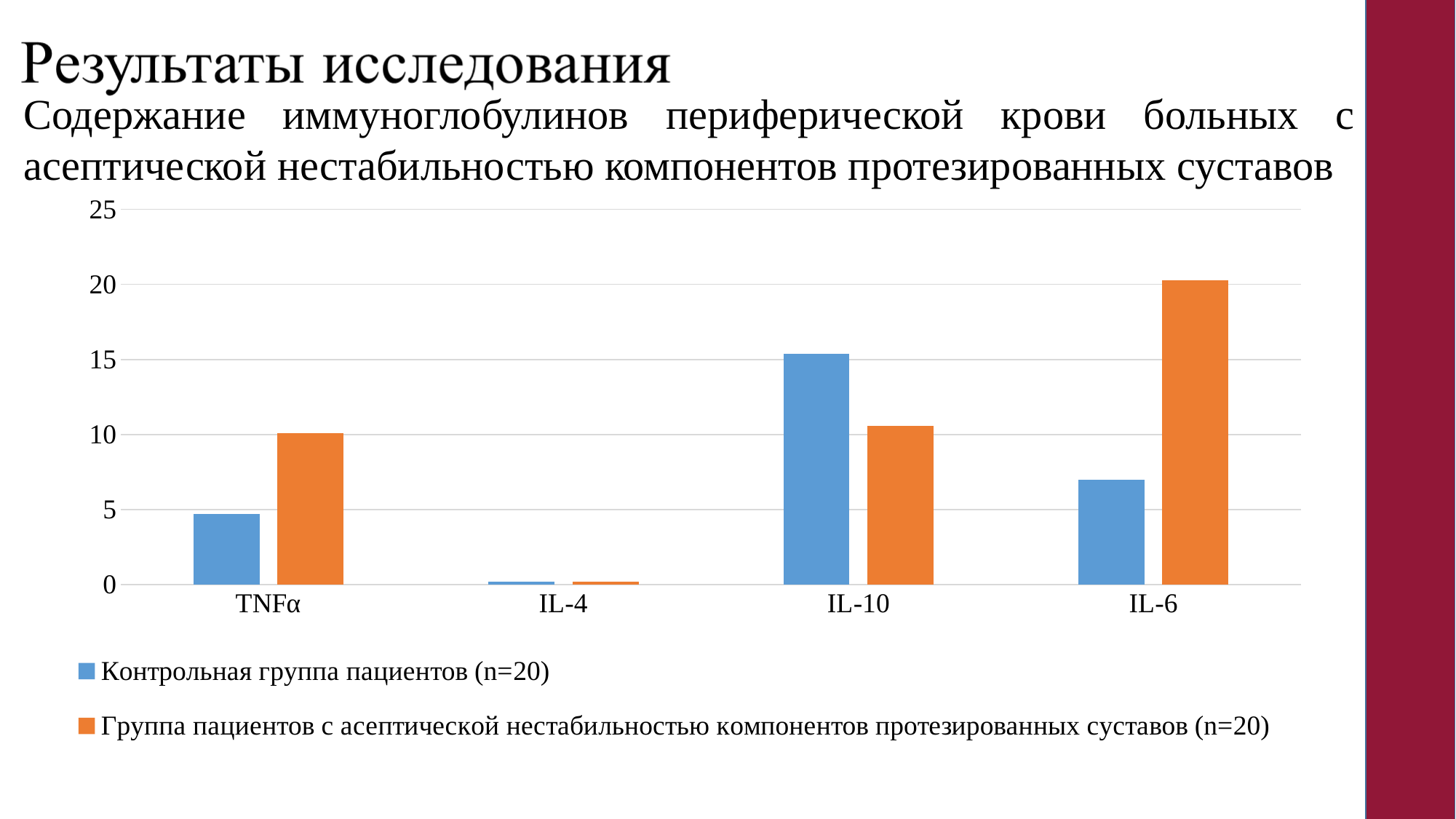
For which category is the value of the series 'Контрольная группа пациентов (n=20)' the lowest? IL-4 For IL-6, which series has the larger value: 'Контрольная группа пациентов (n=20)' or 'Группа пациентов с асептической нестабильностью компонентов протезированных суставов (n=20)'? Группа пациентов с асептической нестабильностью компонентов протезированных суставов (n=20) Which colour represents the series 'Контрольная группа пациентов (n=20)' in the chart? Blue For which category is the value of the series 'Контрольная группа пациентов (n=20)' the highest? IL-10 For IL-10, which series has the larger value: 'Контрольная группа пациентов (n=20)' or 'Группа пациентов с асептической нестабильностью компонентов протезированных суставов (n=20)'? Контрольная группа пациентов (n=20) Is the value for IL-6 in the series 'Группа пациентов с асептической нестабильностью компонентов протезированных суставов (n=20)' greater or less than 15? greater How many series does the chart legend list? 2 For which category is the value of the series 'Группа пациентов с асептической нестабильностью компонентов протезированных суставов (n=20)' the highest? IL-6 What kind of chart is shown on the slide? Bar chart Is the value for IL-10 in the series 'Контрольная группа пациентов (n=20)' greater or less than 10? greater Is the value for IL-6 in the series 'Контрольная группа пациентов (n=20)' greater or less than 10? less How many categories are shown on the x axis of the chart? 4